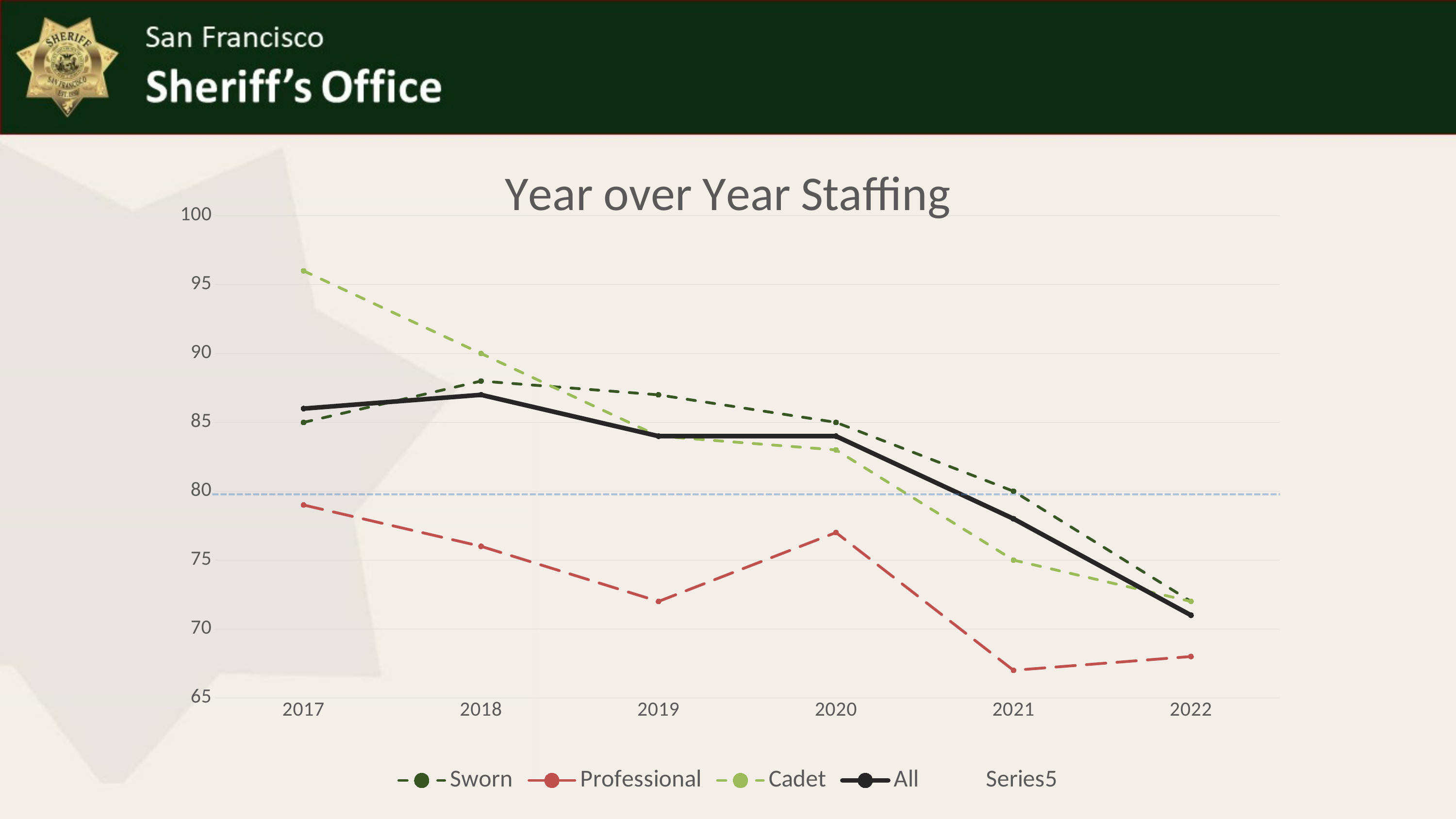
Which series has the highest value in 2017? Cadet How many years are shown on the x axis? 6 Is the value for All in 2022 greater or less than 75? less In 2019, which is larger, the value for Sworn or the value for Professional? Sworn What is the title of the chart? Year over Year Staffing Which series has the lowest value in 2021? Professional Does the All series rise or fall from 2018 to 2022? fall What kind of chart is shown on the slide? line chart Which series is drawn as a solid black line? All How many series does the legend list? 5 Is the value for Professional in 2021 greater or less than 70? less Is the value for Cadet in 2017 greater or less than 95? greater